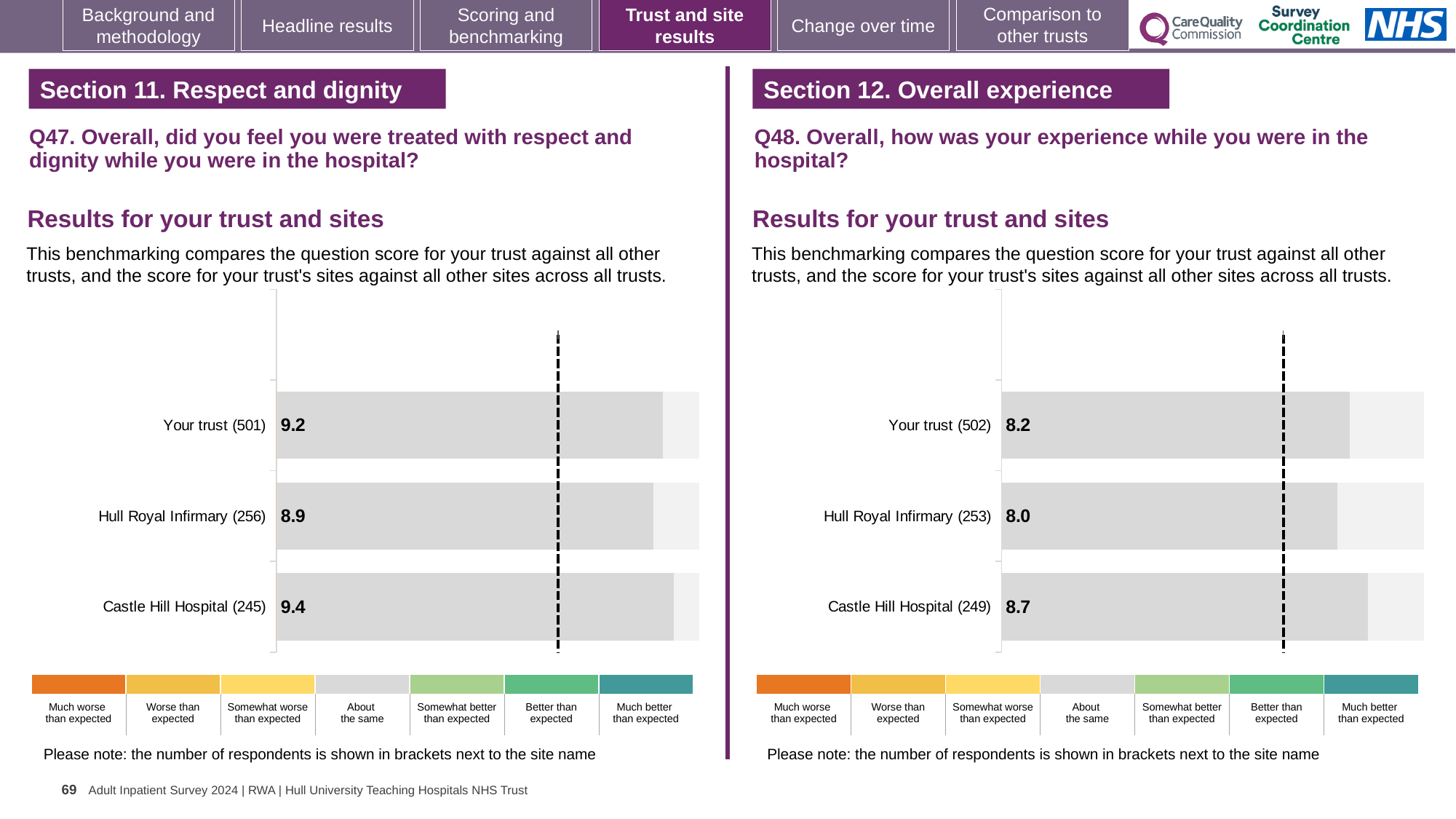
In the Q48 chart on the right, what is the score for Your trust (502)? 8.2 In the Q47 chart on the left, how many respondents are shown in brackets for Castle Hill Hospital? 245 In the Q47 chart on the left, what is the score for Your trust (501)? 9.2 How many bars are shown in the Q47 chart on the left? 3 In the Q47 chart on the left, what is the score for Hull Royal Infirmary (256)? 8.9 In the Q47 chart on the left, what is the difference between the scores for Castle Hill Hospital and Hull Royal Infirmary? 0.5 In the Q48 chart on the right, what is the difference between the scores for Castle Hill Hospital and Your trust? 0.5 In the Q48 chart on the right, which site or trust has the lowest score? Hull Royal Infirmary (253) In the Q47 chart on the left, which site or trust has the highest score? Castle Hill Hospital (245) What type of chart is used in the Q48 chart on the right? Bar chart In the Q48 chart on the right, what is the score for Castle Hill Hospital (249)? 8.7 In the Q48 chart on the right, which has the larger score, Your trust or Hull Royal Infirmary? Your trust